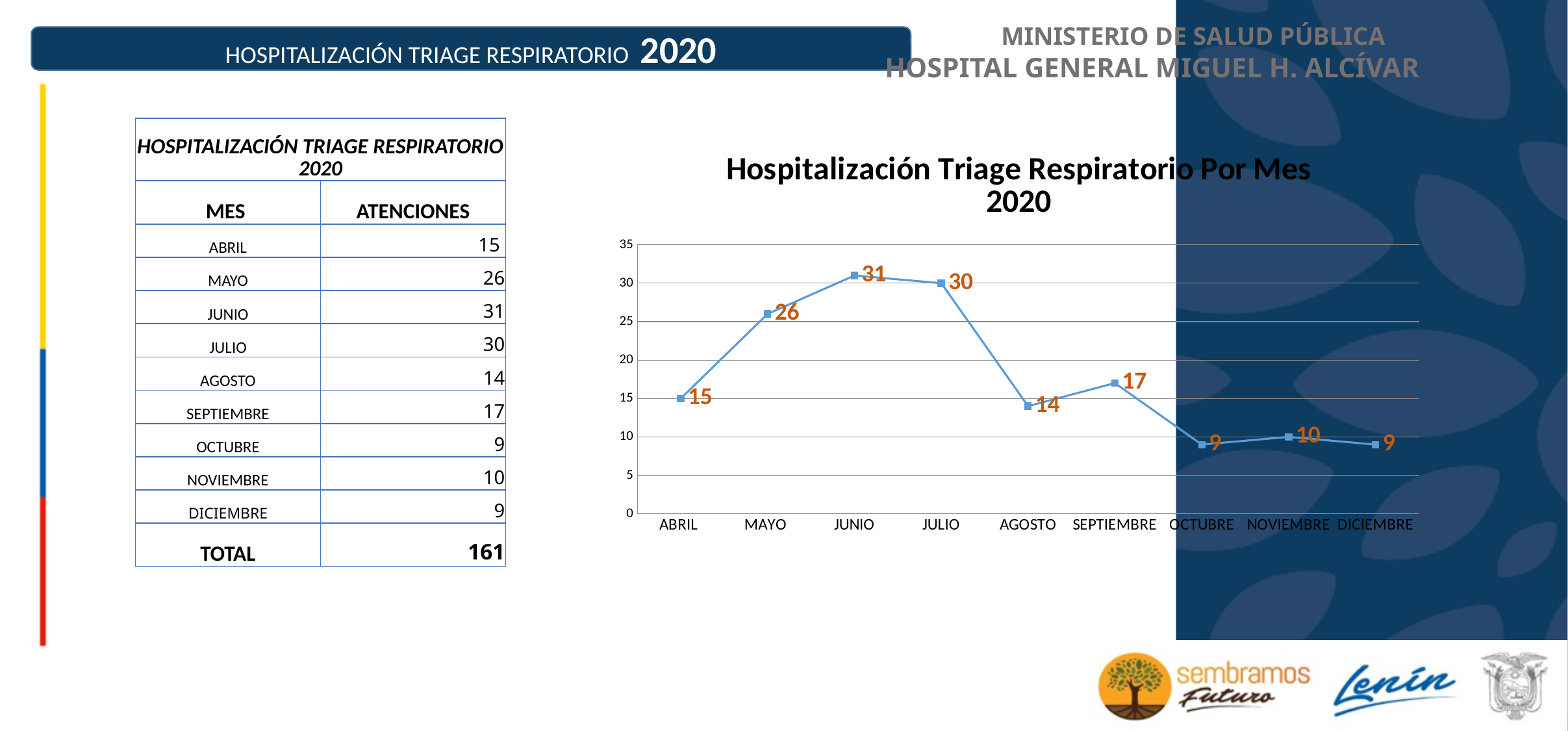
Is the value for JULIO greater or less than 25? greater What is the title of the chart? Hospitalización Triage Respiratorio Por Mes 2020 What is the value for NOVIEMBRE in the chart? 10 What is the value for AGOSTO in the chart? 14 Which is larger, the value for MAYO or the value for AGOSTO? MAYO How many months are plotted on the x axis of the chart? 9 What is the value for JUNIO in the chart? 31 What is the highest value shown on the chart's vertical axis? 35 Which month has the highest value in the chart? JUNIO What is the difference between the values for JULIO and SEPTIEMBRE? 13 Do the values rise or fall from JULIO to AGOSTO? fall What kind of chart is shown on the slide? line chart